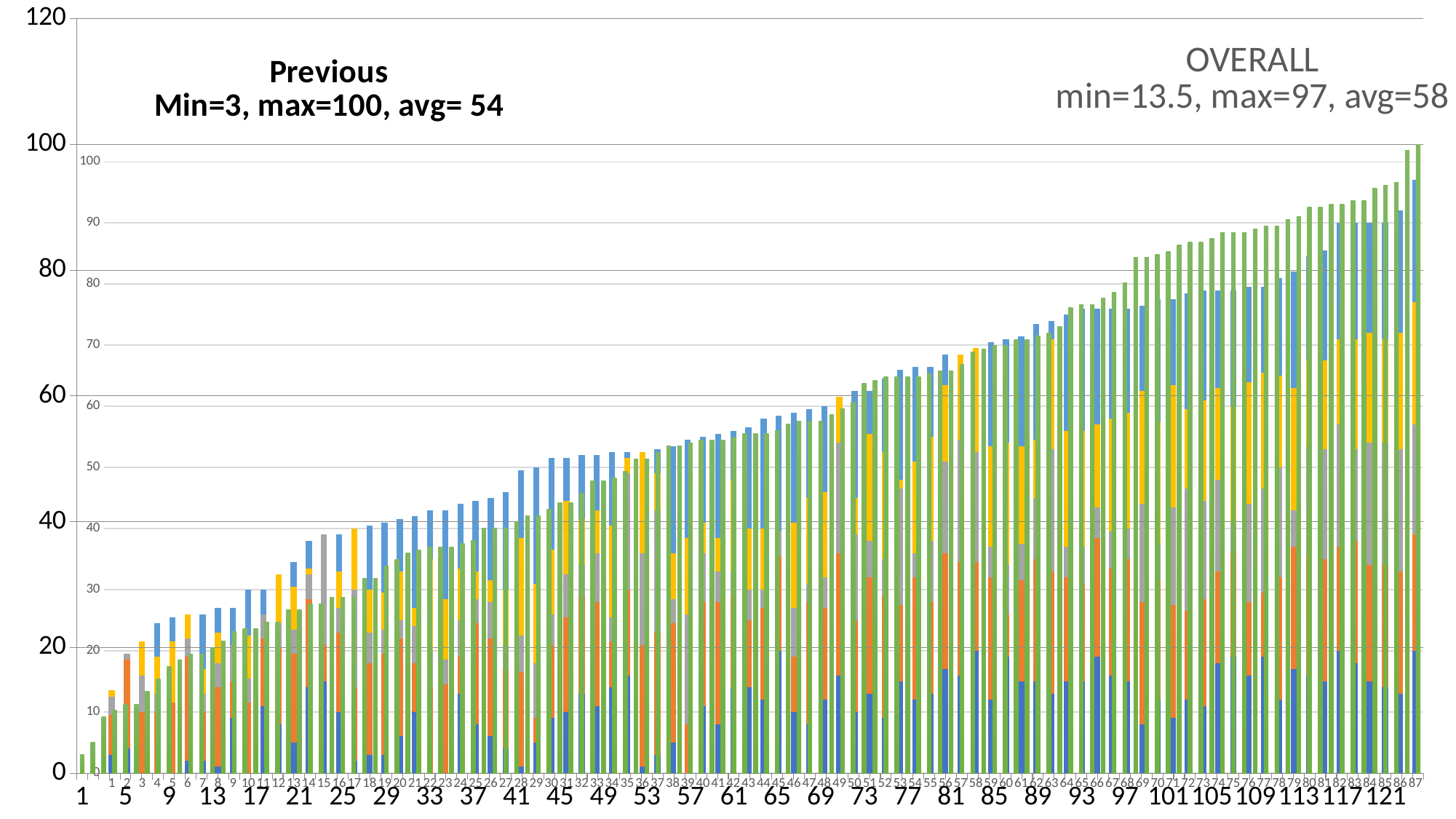
According to the text on the slide, what is the minimum value for the Previous data? 3 How many bars does the OVERALL (foreground) chart have, based on its x-axis labels? 87 What is the difference between the OVERALL average and the Previous average? 4 What is the highest value shown on the outer left y axis? 120 What kind of chart is shown on the slide? Bar chart What is the difference between the Previous maximum and the OVERALL maximum? 3 According to the text on the slide, what is the maximum value for the Previous data? 100 Do the bar values rise or fall from left to right along the x axis? Rise Is the value of the last bar (87) in the OVERALL chart greater or less than 90? greater According to the text on the slide, what is the minimum value for the OVERALL data? 13.5 Which has the higher average, Previous or OVERALL? OVERALL According to the text on the slide, what is the average for the OVERALL data? 58